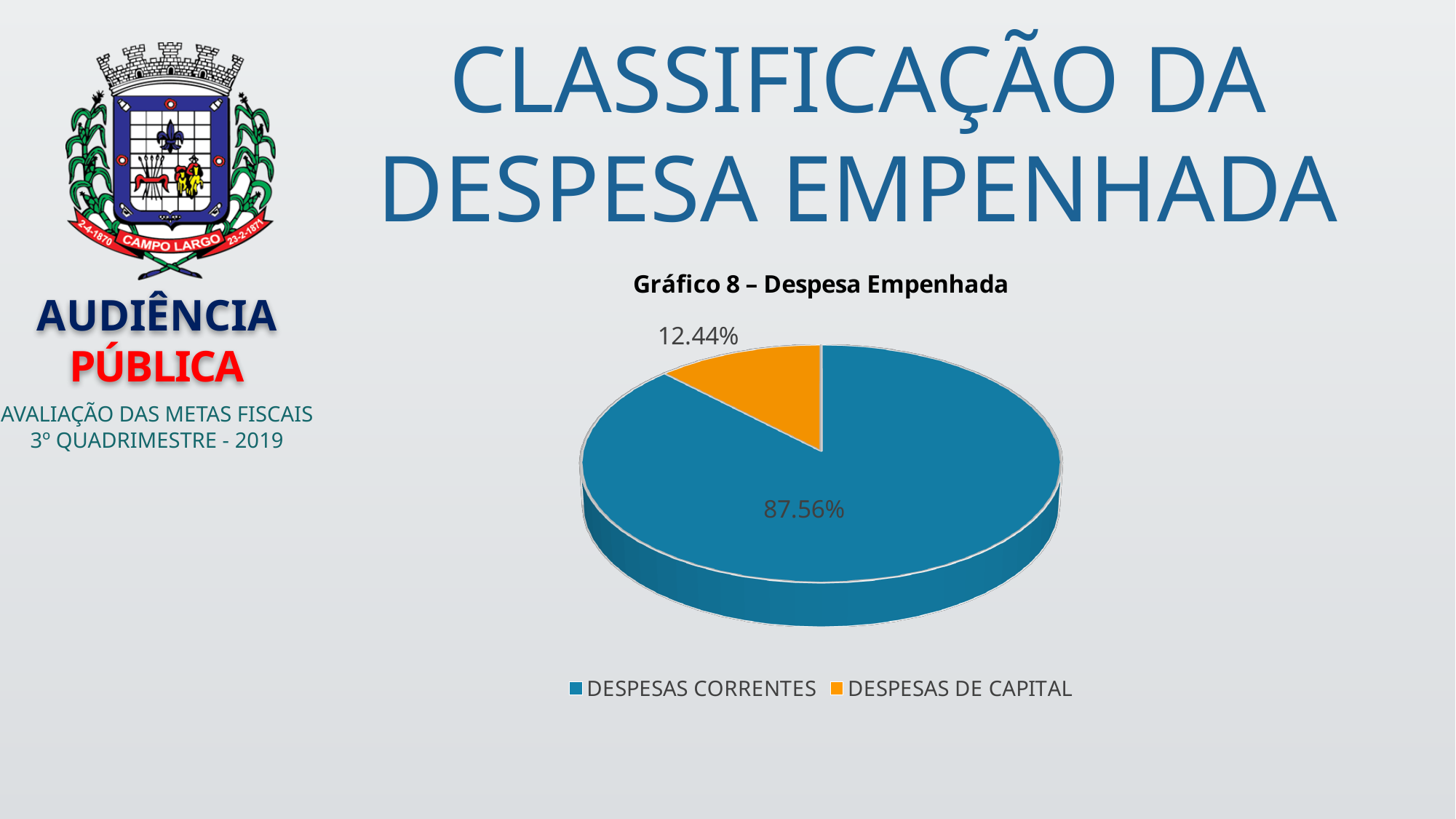
What is the title of the chart? Gráfico 8 – Despesa Empenhada How many entries does the legend list? 2 What share of the pie does DESPESAS CORRENTES represent? 87.56% Which is larger, DESPESAS CORRENTES or DESPESAS DE CAPITAL? DESPESAS CORRENTES What kind of chart is shown on the slide? Pie chart What is the difference in percentage points between DESPESAS CORRENTES and DESPESAS DE CAPITAL? 75.12 What colour is the DESPESAS DE CAPITAL slice? Orange What share of the pie does DESPESAS DE CAPITAL represent? 12.44% Which category has the largest slice of the pie? DESPESAS CORRENTES How many categories does the pie chart show? 2 Which category has the smallest slice of the pie? DESPESAS DE CAPITAL